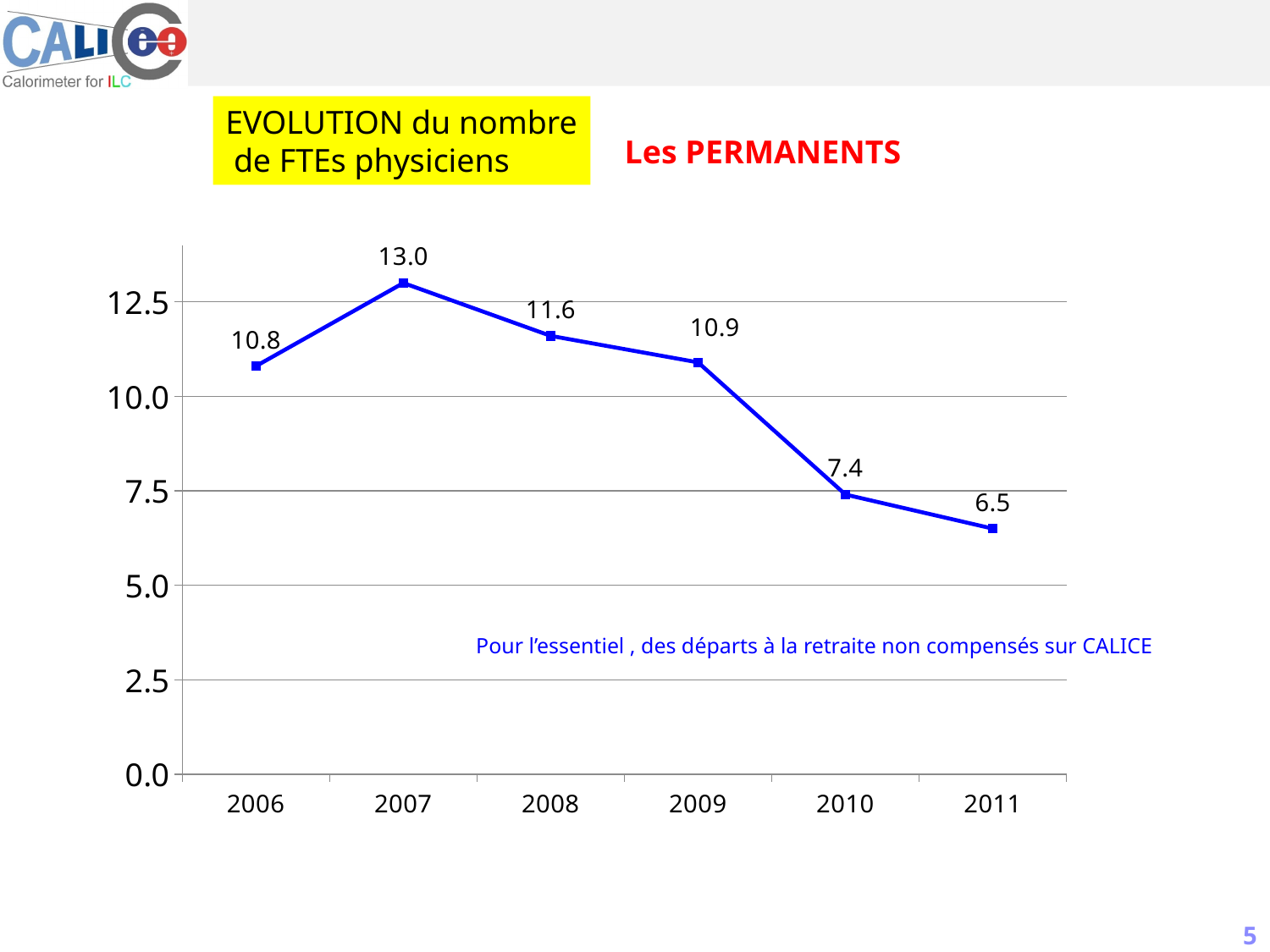
What is the value for 2007? 13.0 Which year has the highest value? 2007 Is the value for 2010 greater or less than 10.0? less What is the difference between the values for 2009 and 2010? 3.5 What is the value for 2011? 6.5 Do the values rise or fall from 2007 to 2011? fall What is the value for 2009? 10.9 What kind of chart is shown on the slide? line chart What is the difference between the values for 2007 and 2011? 6.5 How many years are plotted on the chart? 6 Which year has the lowest value? 2011 Which is larger, the value for 2006 or the value for 2008? 2008